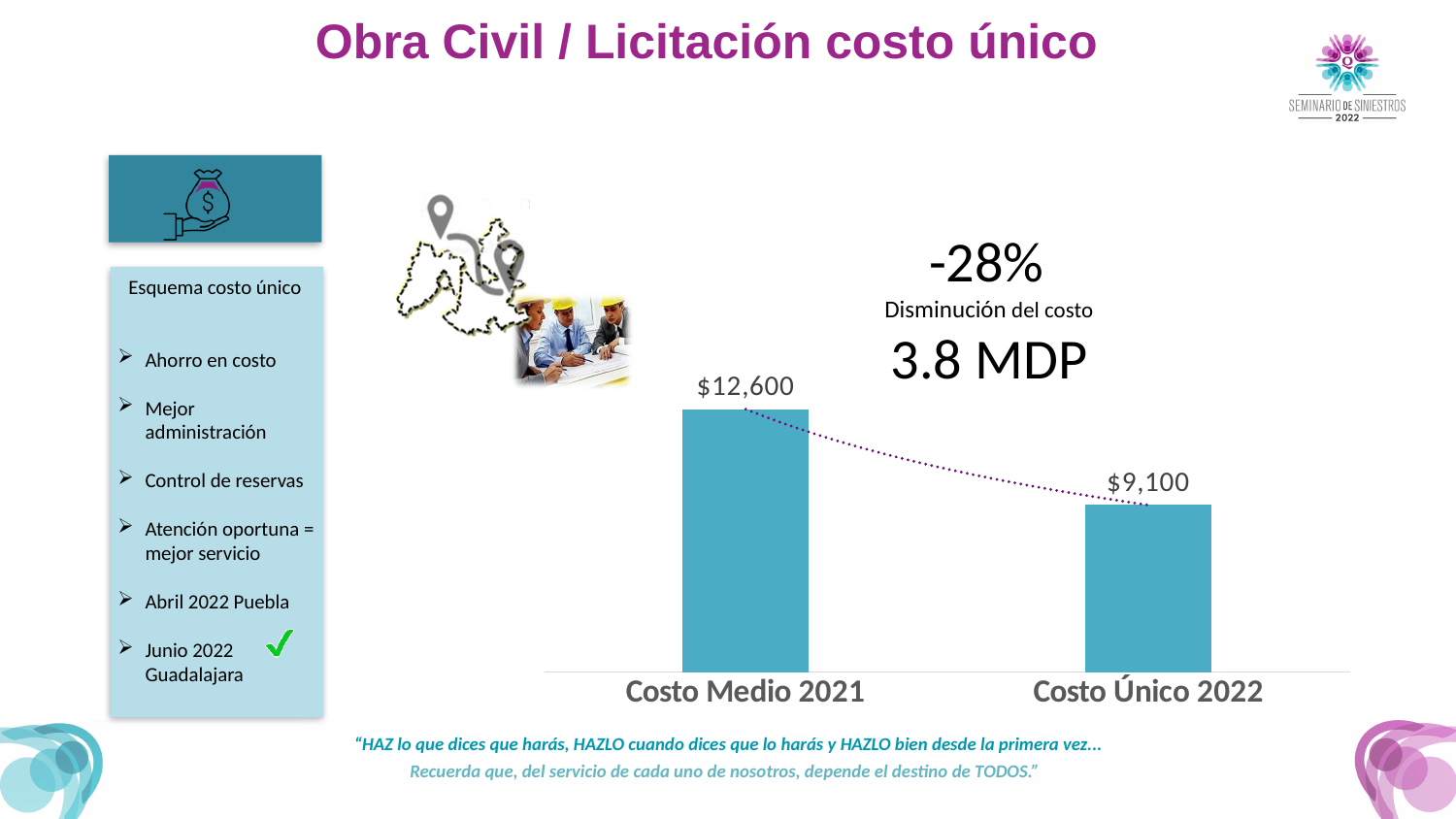
Which category has the lowest value? Costo Único 2022 How many categories are shown in the chart? 2 Which category has the highest value? Costo Medio 2021 What is the value for Costo Único 2022? $9,100 Do the values rise or fall from Costo Medio 2021 to Costo Único 2022? fall What kind of chart is shown on the slide? bar chart Which is larger, Costo Medio 2021 or Costo Único 2022? Costo Medio 2021 What is the difference between Costo Medio 2021 and Costo Único 2022? $3,500 What is the value for Costo Medio 2021? $12,600 What cost reduction in MDP is shown above the chart? 3.8 MDP What percentage decrease is shown above the chart? -28%